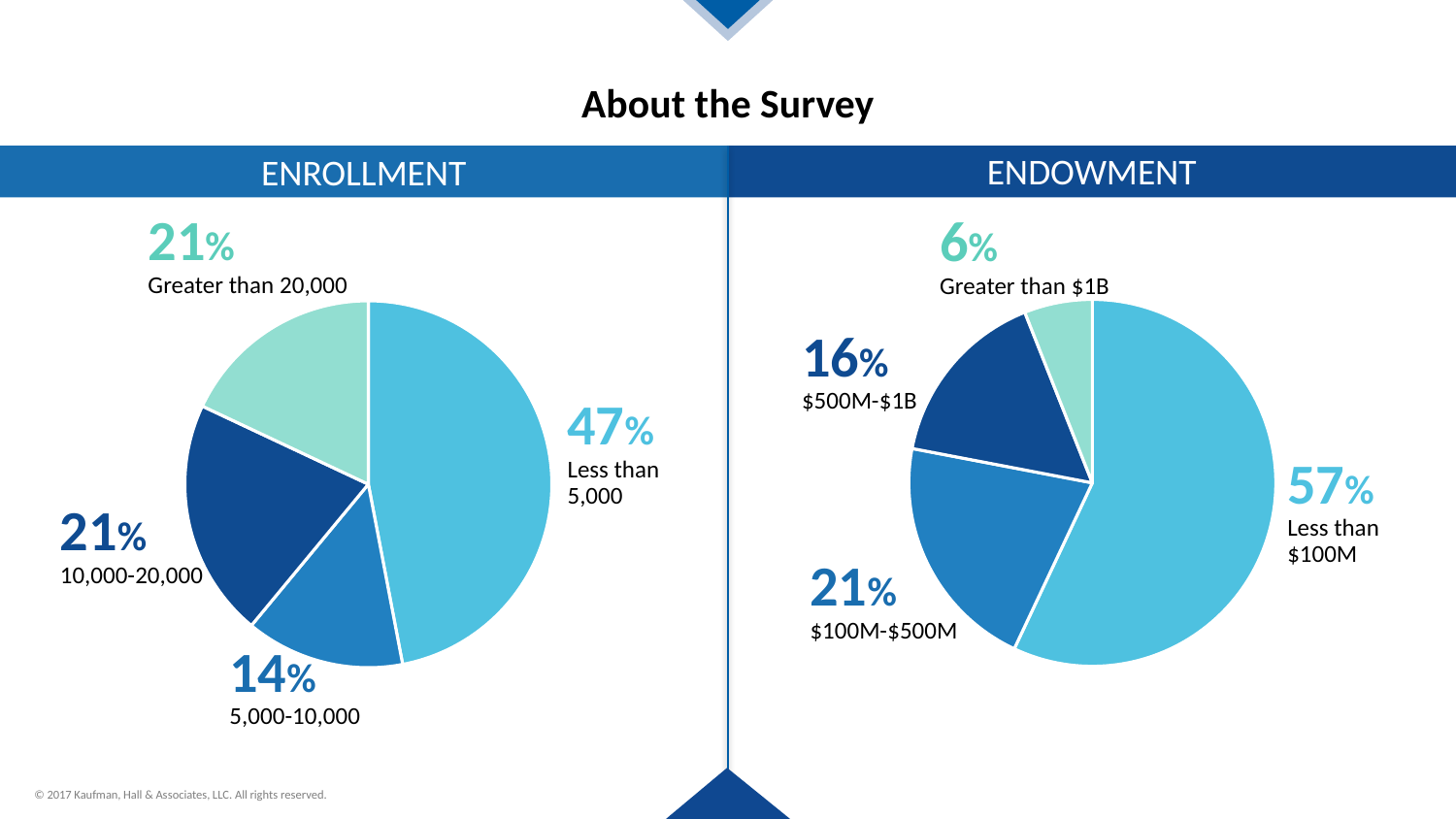
In the Enrollment chart, what share of respondents have enrollment of less than 5,000? 47% What type of chart is used on this slide for the Enrollment and Endowment data? Pie chart In the Enrollment chart, how many categories are shown? 4 In the Enrollment chart, what share of respondents have enrollment of 5,000-10,000? 14% In the Endowment chart, what is the difference between the share for less than $100M and the share for $100M-$500M? 36% In the Endowment chart, what share of respondents have an endowment of $500M-$1B? 16% In the Endowment chart, which endowment category has the largest share? Less than $100M In the Endowment chart, which is larger: the share for $100M-$500M or the share for $500M-$1B? $100M-$500M In the Enrollment chart, what is the difference between the share for less than 5,000 and the share for 5,000-10,000? 33% In the Enrollment chart, which enrollment category has the smallest share? 5,000-10,000 In the Enrollment chart, which enrollment category has the largest share? Less than 5,000 In the Endowment chart, what share of respondents have an endowment greater than $1B? 6%